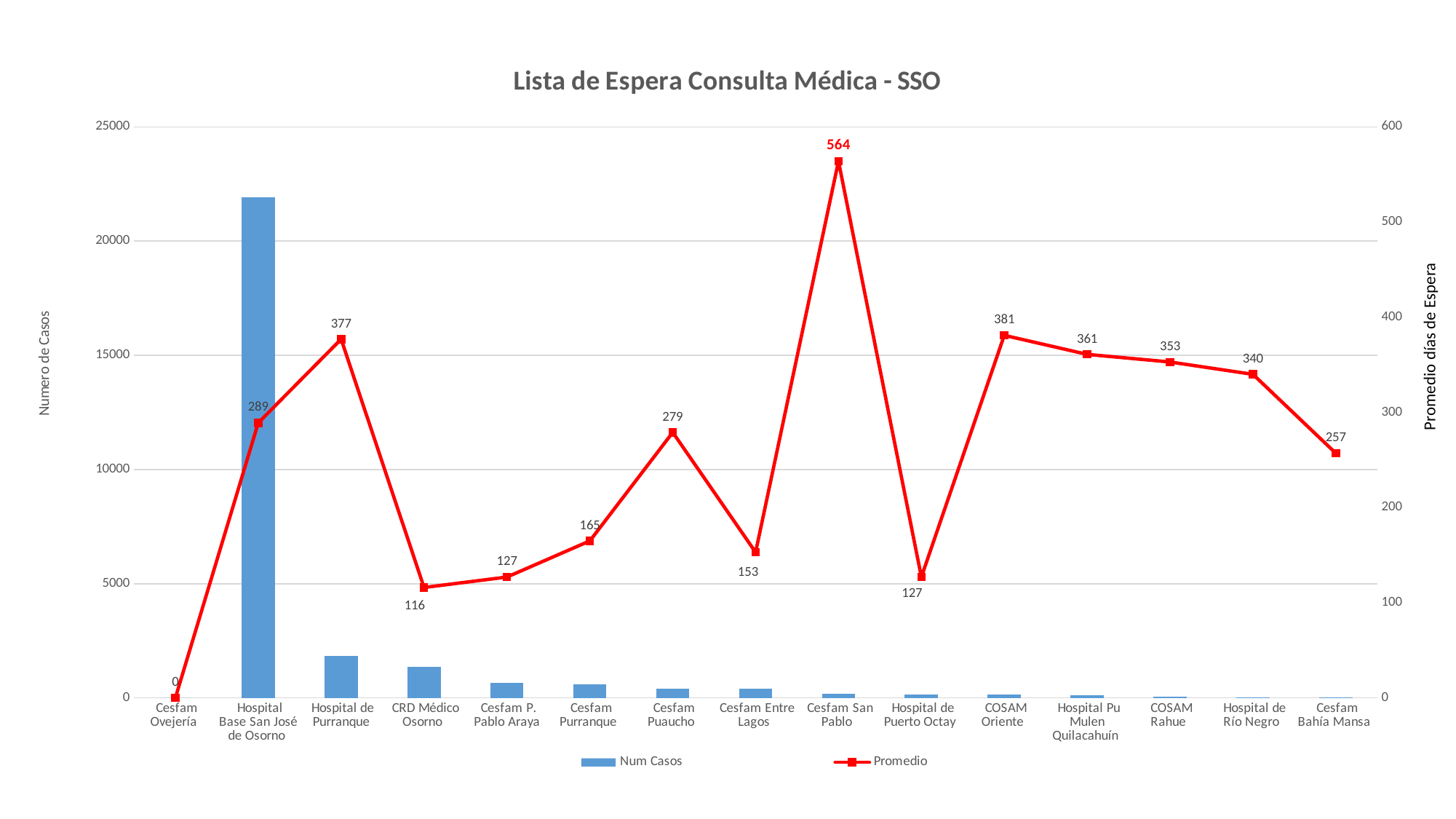
What is the Promedio value for Cesfam San Pablo? 564 Is the Num Casos value for Hospital Base San José de Osorno greater or less than 20000? greater Which category has the lowest Promedio value? Cesfam Ovejería How many series does the legend list? 2 Is the Num Casos value for Hospital de Purranque greater or less than 5000? less What is the Promedio value for Cesfam Bahía Mansa? 257 What is the difference between the Promedio values for COSAM Oriente and Hospital Pu Mulen Quilacahuín? 20 How many categories are shown on the x axis? 15 Which category has the highest Promedio value? Cesfam San Pablo What is the Promedio value for Hospital de Purranque? 377 What is the title of the chart? Lista de Espera Consulta Médica - SSO Which has a larger Promedio value, Cesfam Puaucho or Cesfam Entre Lagos? Cesfam Puaucho